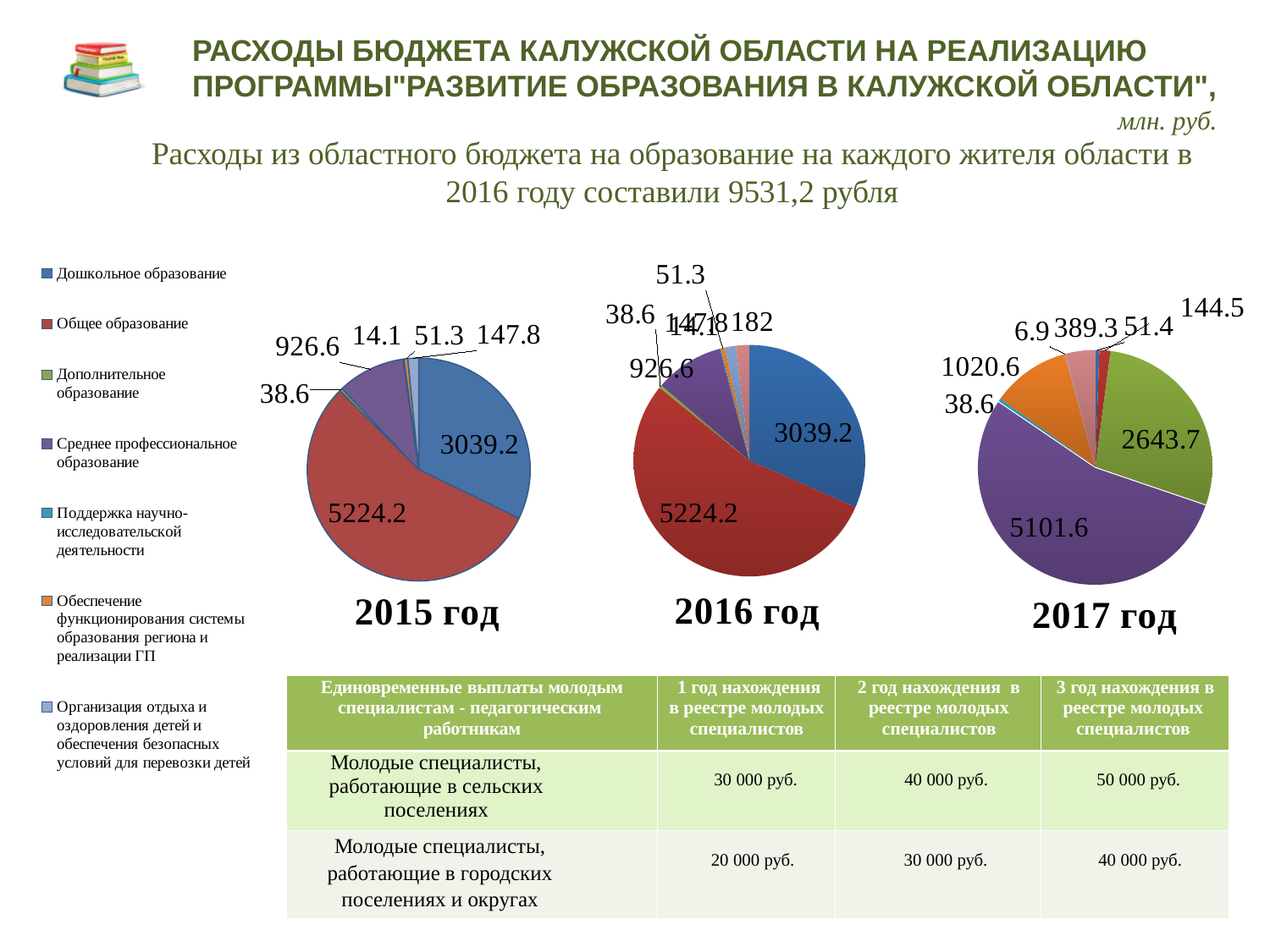
What is the title of the rightmost pie chart? 2017 год In the 2017 год pie chart, what is the difference between the two largest slices, 5101.6 and 2643.7? 2457.9 How many pie charts are on the slide? 3 In the 2015 год pie chart, which is larger: Общее образование or Среднее профессиональное образование? Общее образование In the 2015 год pie chart, which category has the largest slice? Общее образование In the 2015 год pie chart, what is the difference between the values for Общее образование and Дошкольное образование? 2185 How many categories does the legend list? 7 In the 2015 год pie chart, what is the value for Дошкольное образование? 3039.2 In the 2015 год pie chart, what is the value for Среднее профессиональное образование? 926.6 In the 2015 год pie chart, what is the value for Общее образование? 5224.2 What kind of charts are shown on the slide? Pie charts In the 2017 год pie chart, what is the value of the largest slice? 5101.6